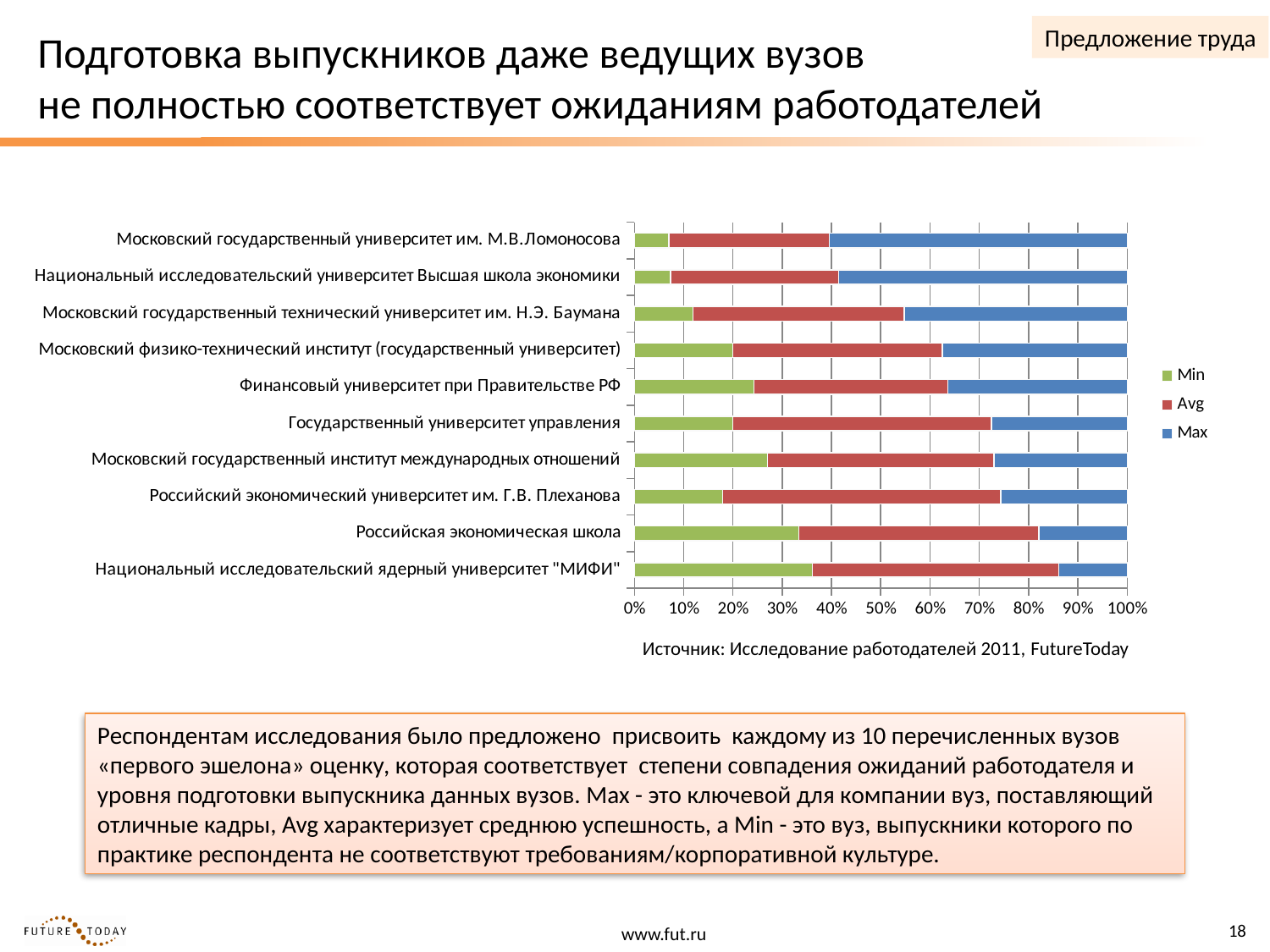
What is the total of each stacked bar in the chart? 100% How many series does the chart legend list? 3 Which university has the largest Min segment? Национальный исследовательский ядерный университет "МИФИ" Is the Min value for Московский государственный университет им. М.В.Ломоносова greater or less than 10%? less Which has the larger Min value: Московский государственный институт международных отношений or Московский государственный технический университет им. Н.Э. Баумана? Московский государственный институт международных отношений What are the series names shown in the chart legend? Min, Avg, Max Is the Min value for Национальный исследовательский ядерный университет "МИФИ" greater or less than 30%? greater Is the Min value for Финансовый университет при Правительстве РФ greater or less than 20%? greater How many universities are listed as categories in the chart? 10 Which university has the smallest Max segment? Национальный исследовательский ядерный университет "МИФИ" What kind of chart is shown on the slide? stacked bar chart